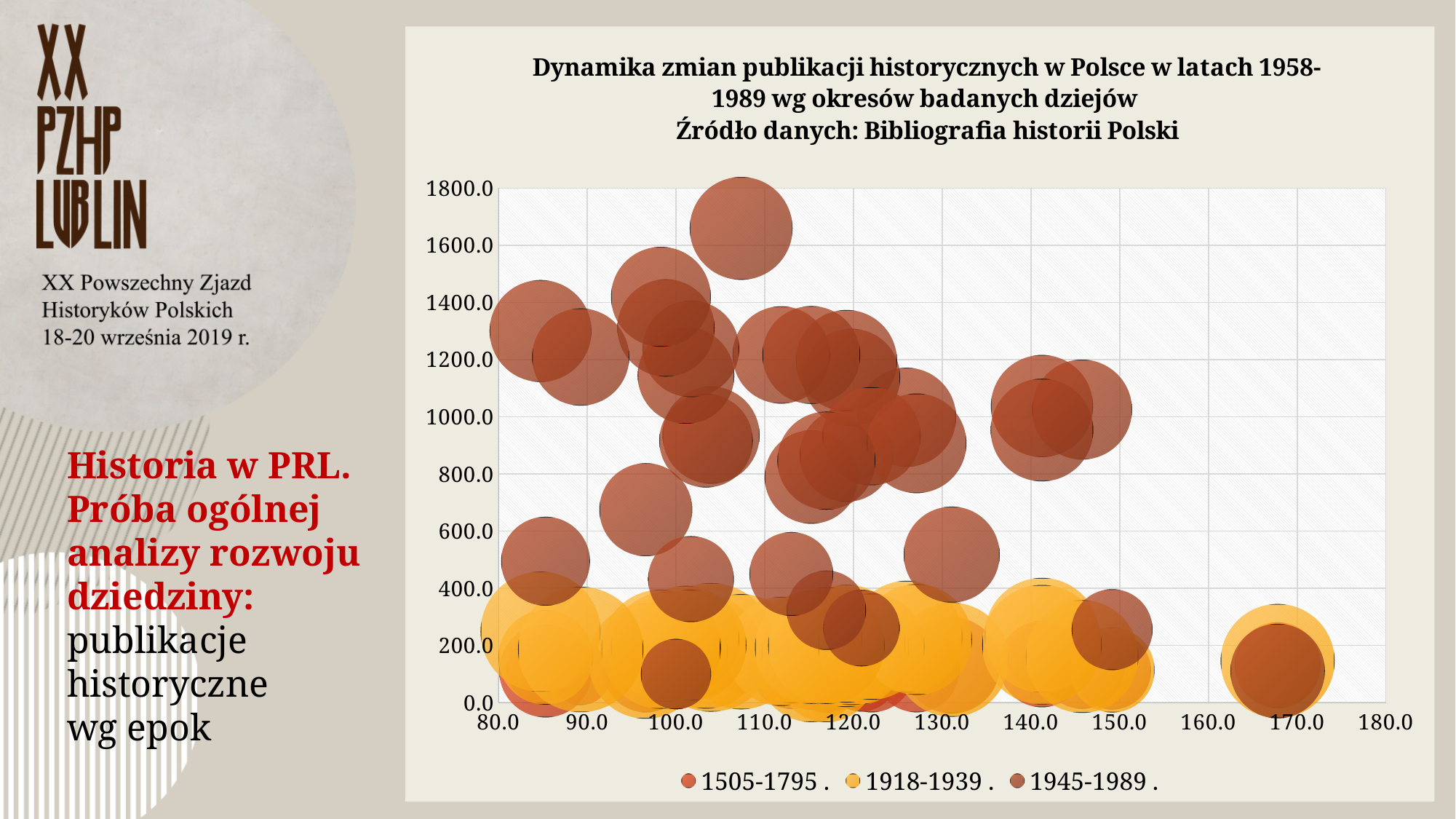
What is the source of the data named in the chart title? Bibliografia historii Polski What is the highest tick value shown on the vertical axis? 1800.0 Are the bubbles of the 1918-1939 series mostly greater or less than 400.0 on the vertical axis? less How many series does the legend list? 3 Which series has the bubbles reaching the highest values on the vertical axis? 1945-1989 Which series has bubbles at higher vertical-axis values overall, 1918-1939 or 1945-1989? 1945-1989 Is the rightmost bubble on the chart greater or less than 160.0 on the horizontal axis? greater What kind of chart is shown on the slide? bubble chart What is the highest tick value shown on the horizontal axis? 180.0 What are the three series named in the legend? 1505-1795, 1918-1939, 1945-1989 Is the highest bubble of the 1945-1989 series greater or less than 1600.0 on the vertical axis? greater